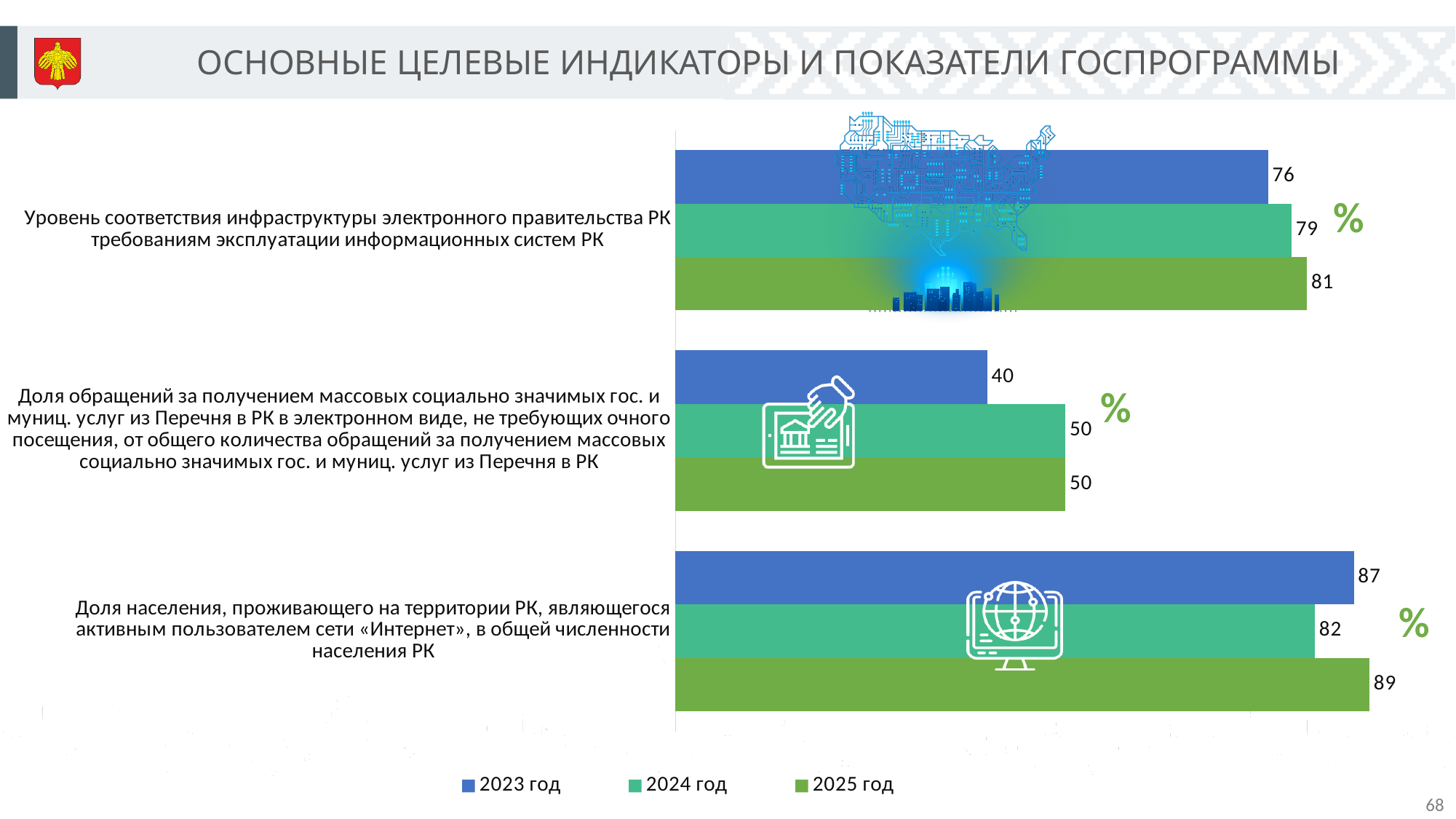
Which year has the lowest value for the indicator 'Доля обращений за получением массовых социально значимых гос. и муниц. услуг из Перечня в РК в электронном виде'? 2023 год For the indicator 'Доля населения, проживающего на территории РК, являющегося активным пользователем сети «Интернет»', which is larger: the 2023 год value or the 2024 год value? 2023 год How many series does the legend list? 3 What is the 2023 год value for the indicator 'Доля обращений за получением массовых социально значимых гос. и муниц. услуг из Перечня в РК в электронном виде'? 40 What is the 2025 год value for the indicator 'Уровень соответствия инфраструктуры электронного правительства РК требованиям эксплуатации информационных систем РК'? 81 What is the 2024 год value for the indicator 'Доля населения, проживающего на территории РК, являющегося активным пользователем сети «Интернет»'? 82 What kind of chart is shown on the slide? bar chart Which year has the highest value for the indicator 'Доля населения, проживающего на территории РК, являющегося активным пользователем сети «Интернет»'? 2025 год How many categories (indicators) are plotted on the chart? 3 Which legend entry is shown in green? 2025 год What is the 2023 год value for the indicator 'Уровень соответствия инфраструктуры электронного правительства РК требованиям эксплуатации информационных систем РК'? 76 What is the difference between the 2025 год and 2023 год values for the indicator 'Уровень соответствия инфраструктуры электронного правительства РК требованиям эксплуатации информационных систем РК'? 5